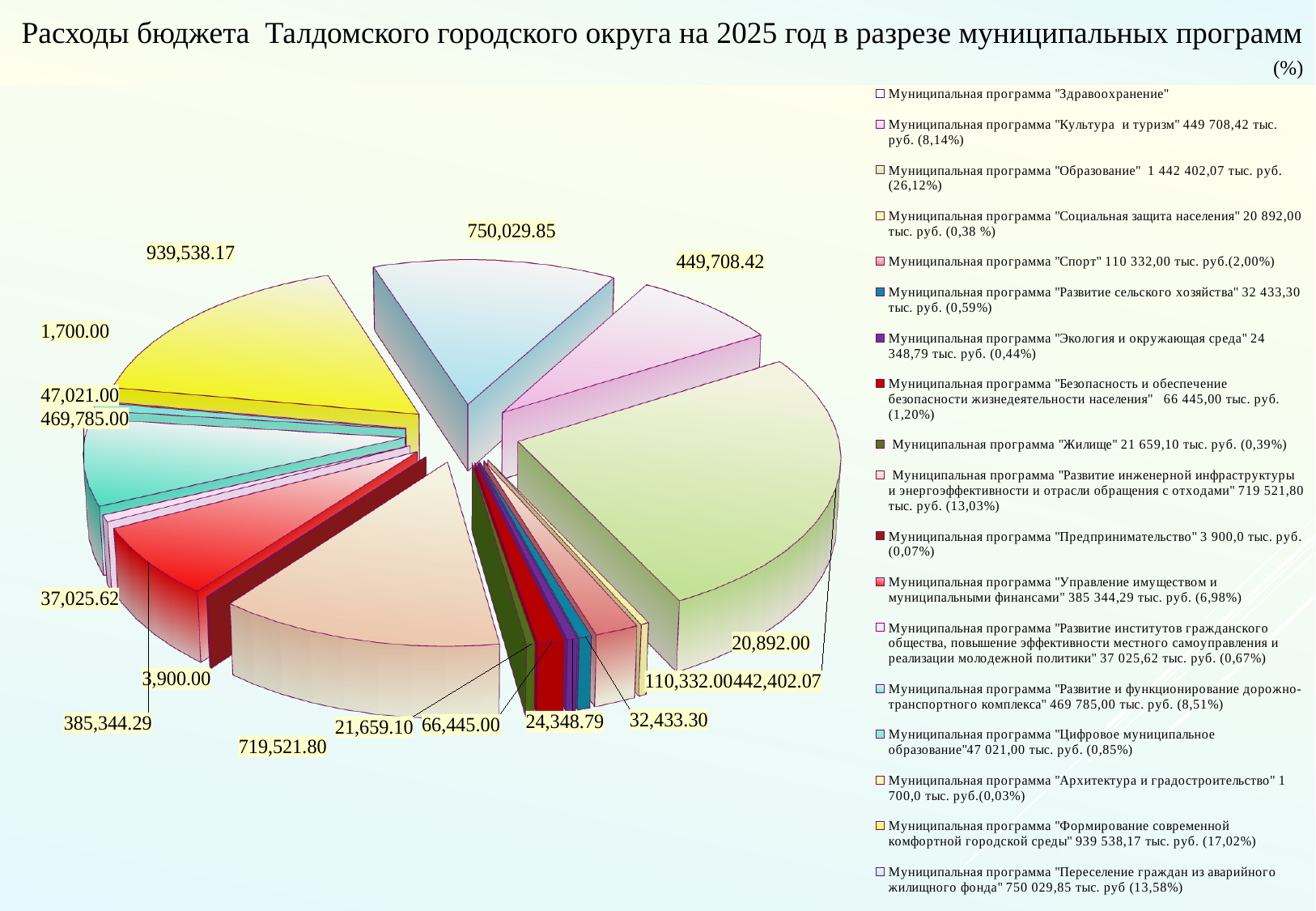
Which municipal programme has the largest share of the budget? Муниципальная программа "Образование" What share of the budget does the municipal programme "Образование" account for, according to the legend? 26,12% What is the value shown for the municipal programme "Развитие инженерной инфраструктуры и энергоэффективности и отрасли обращения с отходами"? 719,521.80 How many entries does the chart legend list? 18 What unit is indicated in parentheses under the chart title? % What kind of chart is shown on the slide? pie chart What is the value shown for the municipal programme "Культура и туризм"? 449,708.42 What is the value shown for the municipal programme "Формирование современной комфортной городской среды"? 939,538.17 What is the difference between the values for "Формирование современной комфортной городской среды" (939,538.17) and "Переселение граждан из аварийного жилищного фонда" (750,029.85)? 189,508.32 Which is larger: the value for "Формирование современной комфортной городской среды" or the value for "Переселение граждан из аварийного жилищного фонда"? Формирование современной комфортной городской среды What is the value shown for the municipal programme "Переселение граждан из аварийного жилищного фонда"? 750,029.85 Which municipal programme has the smallest value on the chart? Муниципальная программа "Архитектура и градостроительство"